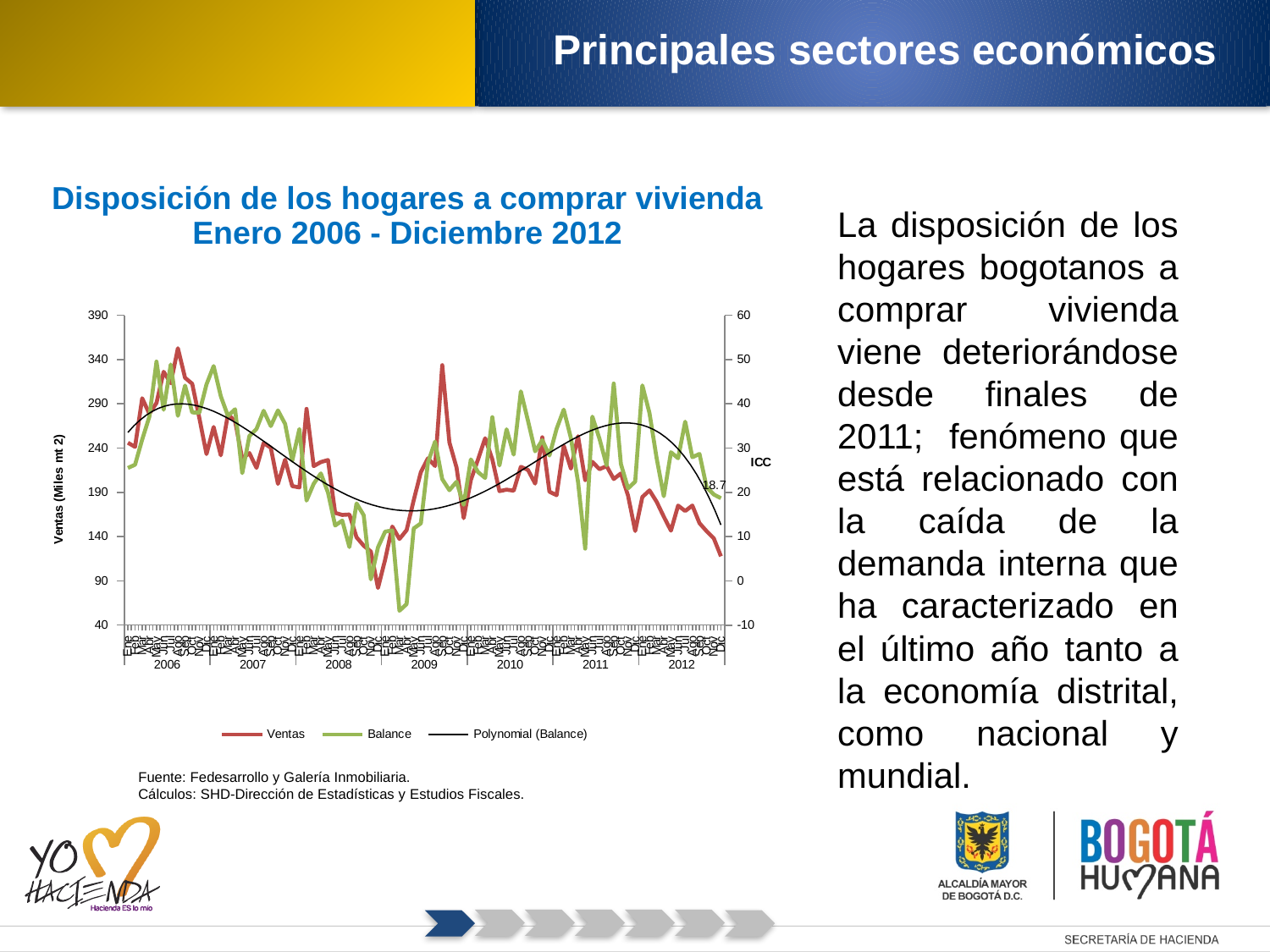
What kind of chart is shown on the slide? Line chart What is the lowest tick value shown on the right axis (ICC)? -10 What is the title of the chart? Disposición de los hogares a comprar vivienda Enero 2006 - Diciembre 2012 Is the value of Ventas at the end of 2012 greater or less than 140? less What is the highest tick value shown on the left axis (Ventas)? 390 How many years are labelled along the x axis of the chart? 7 What value is labelled at the end of the Balance series in December 2012? 18.7 How many entries does the chart legend list? 3 Is the lowest value of the Balance series, reached around the end of 2008, greater or less than 0? less Is the peak value of Ventas in 2006 greater or less than 340? greater Do the Ventas values rise or fall from 2011 to the end of 2012? fall Which series is drawn in red in the chart? Ventas